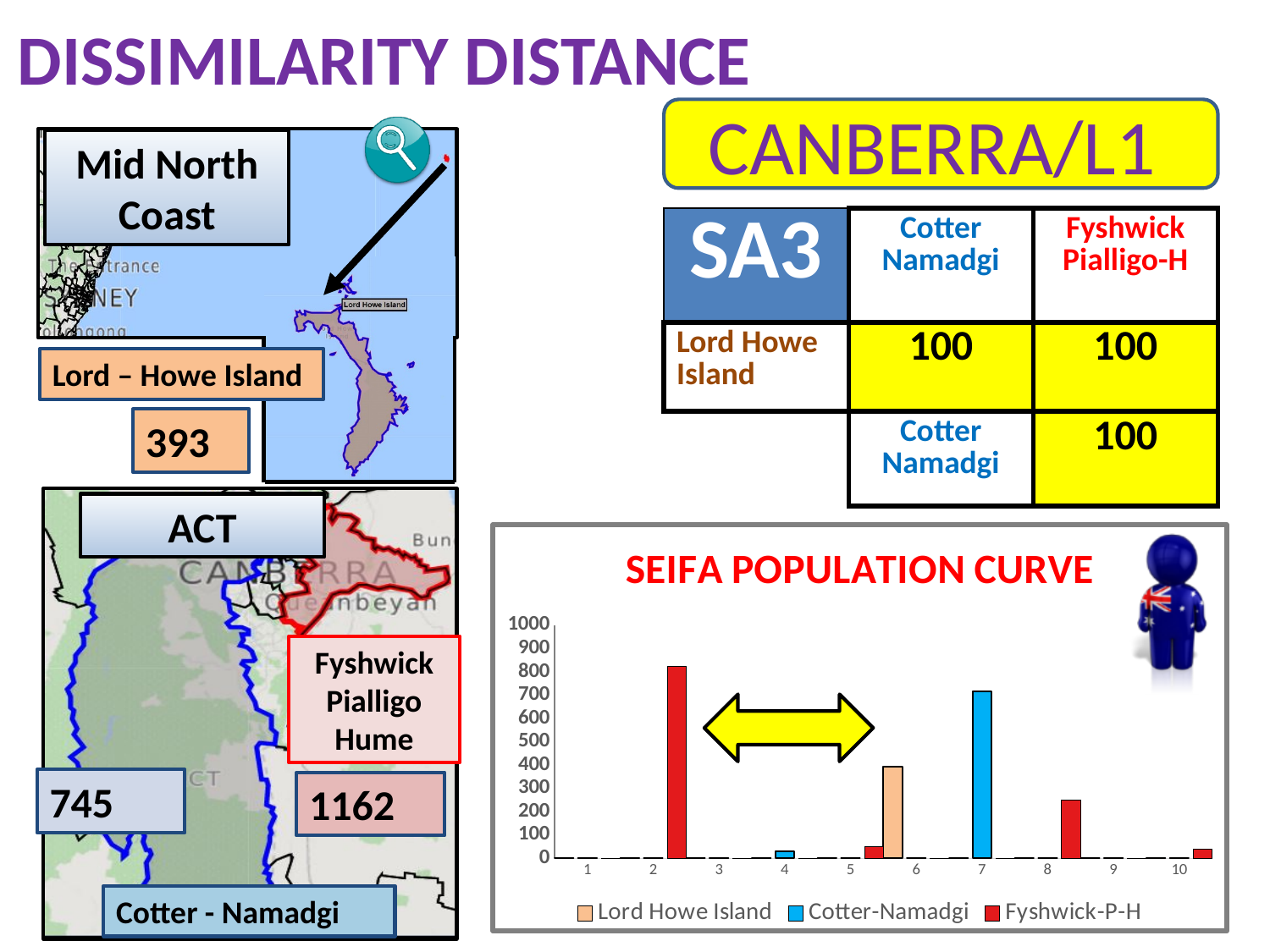
In the SEIFA POPULATION CURVE chart, is the value for Lord Howe Island at category 6 greater or less than 500? less How many series does the legend of the SEIFA POPULATION CURVE chart list? 3 In the SEIFA POPULATION CURVE chart, is the value for Fyshwick-P-H at category 2 greater or less than 700? greater In the SEIFA POPULATION CURVE chart, is the value for Cotter-Namadgi at category 7 greater or less than 600? greater In the SEIFA POPULATION CURVE chart, which is larger: Cotter-Namadgi at category 7 or Lord Howe Island at category 6? Cotter-Namadgi at category 7 What kind of chart is the SEIFA POPULATION CURVE chart? bar chart In the SEIFA POPULATION CURVE chart, which is larger: Lord Howe Island at category 6 or Fyshwick-P-H at category 8? Lord Howe Island at category 6 Which series in the SEIFA POPULATION CURVE chart is shown in red? Fyshwick-P-H What is the title of the chart on the slide? SEIFA POPULATION CURVE How many categories are shown on the x axis of the SEIFA POPULATION CURVE chart? 10 In the SEIFA POPULATION CURVE chart, which series has the tallest bar overall? Fyshwick-P-H In the SEIFA POPULATION CURVE chart, at which x-axis category does Fyshwick-P-H have its tallest bar? 2